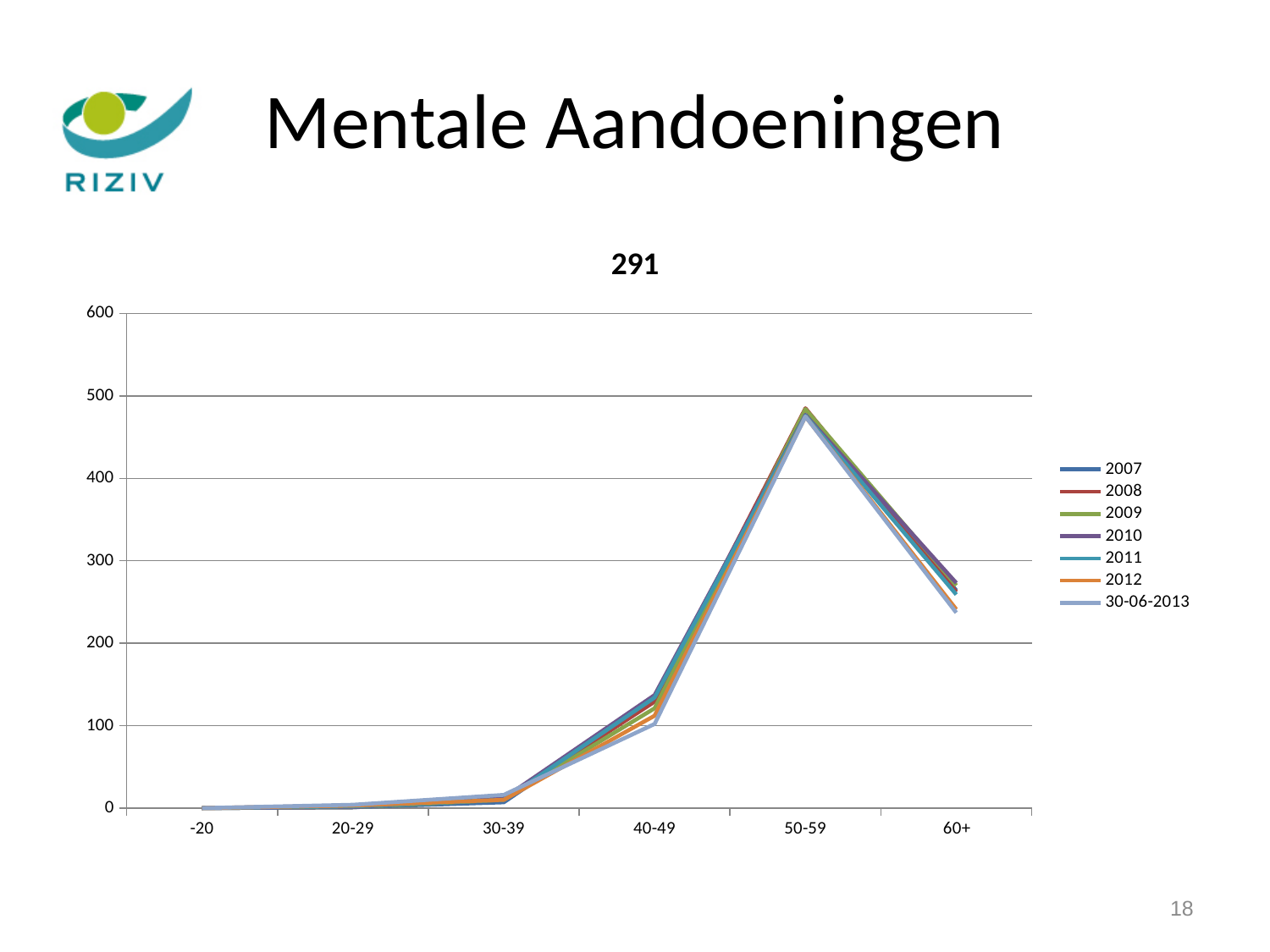
Is the value for 60+ in the 30-06-2013 series greater or less than 300? less What kind of chart is shown on the slide? line chart What is the title of the chart? 291 Which age category has the highest value for the 2009 series? 50-59 Which age category has the lowest value for the 2012 series? -20 Is the value for 50-59 in the 2007 series greater or less than 400? greater How many series does the legend list? 7 Is the value for 30-39 in the 2010 series greater or less than 100? less For the 2011 series, which is larger: the value for 50-59 or the value for 60+? 50-59 How many age categories are shown on the x axis? 6 What is the label of the last entry in the legend? 30-06-2013 Do the values for the 2008 series rise or fall from 50-59 to 60+? fall